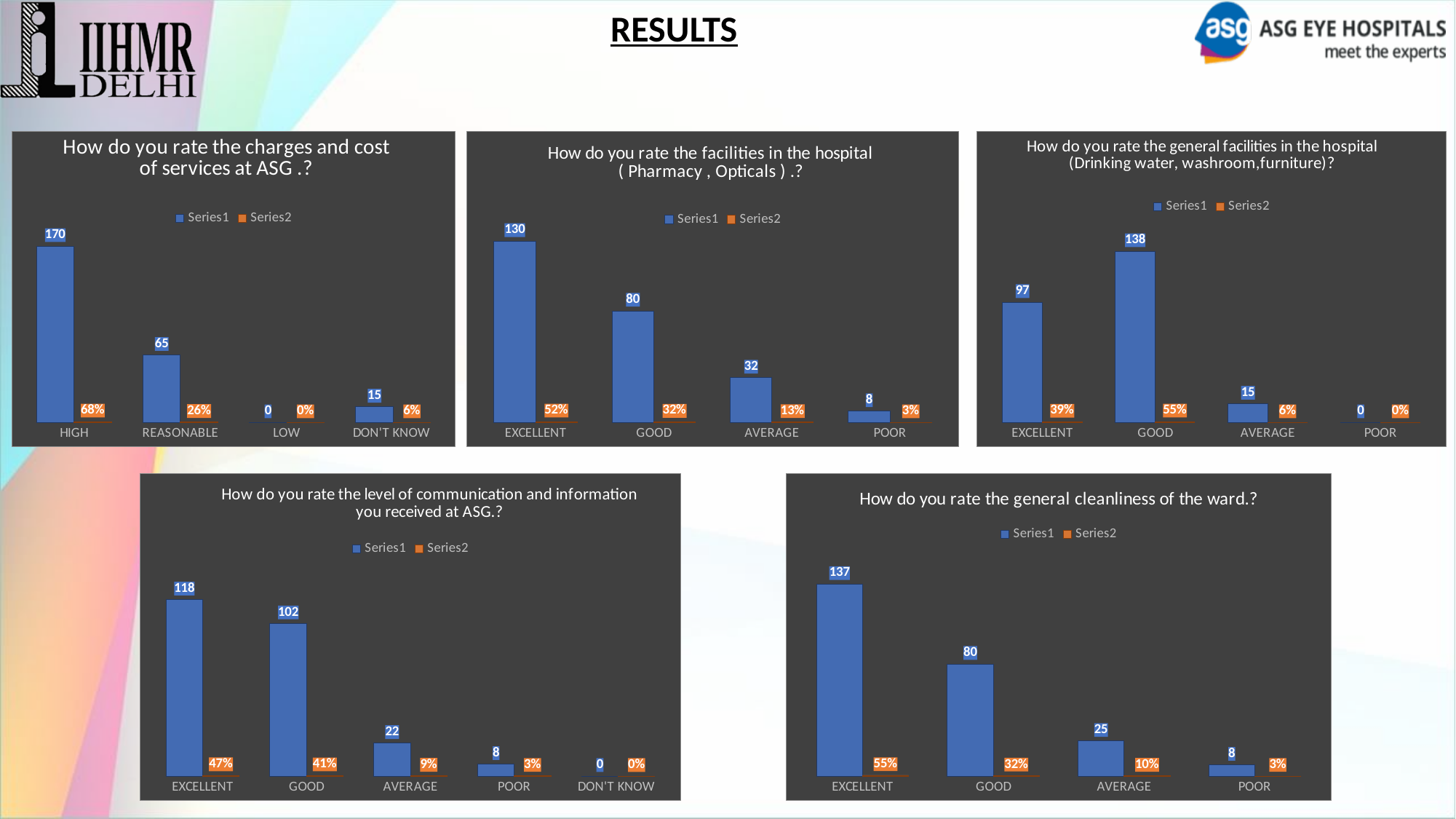
In the chart 'How do you rate the level of communication and information you received at ASG.?', how many categories are shown on the x axis? 5 In the chart 'How do you rate the facilities in the hospital ( Pharmacy , Opticals ) .?', what is the difference between the Series1 values for EXCELLENT and GOOD? 50 In the chart 'How do you rate the charges and cost of services at ASG .?', what is the Series2 value for REASONABLE? 26% In the chart 'How do you rate the level of communication and information you received at ASG.?', which is larger, the Series1 value for EXCELLENT or for GOOD? EXCELLENT What type of chart is 'How do you rate the charges and cost of services at ASG .?'? Bar chart In the chart 'How do you rate the general facilities in the hospital (Drinking water, washroom,furniture)?', what is the Series2 value for EXCELLENT? 39% How many series does the legend list in the chart 'How do you rate the general cleanliness of the ward.?'? 2 In the chart 'How do you rate the general facilities in the hospital (Drinking water, washroom,furniture)?', which category has the highest Series1 value? GOOD In the chart 'How do you rate the charges and cost of services at ASG .?', what is the Series1 value for HIGH? 170 In the chart 'How do you rate the general cleanliness of the ward.?', what is the Series1 value for AVERAGE? 25 In the chart 'How do you rate the facilities in the hospital ( Pharmacy , Opticals ) .?', which category has the highest Series1 value? EXCELLENT In the chart 'How do you rate the general cleanliness of the ward.?', which category has the lowest Series1 value? POOR